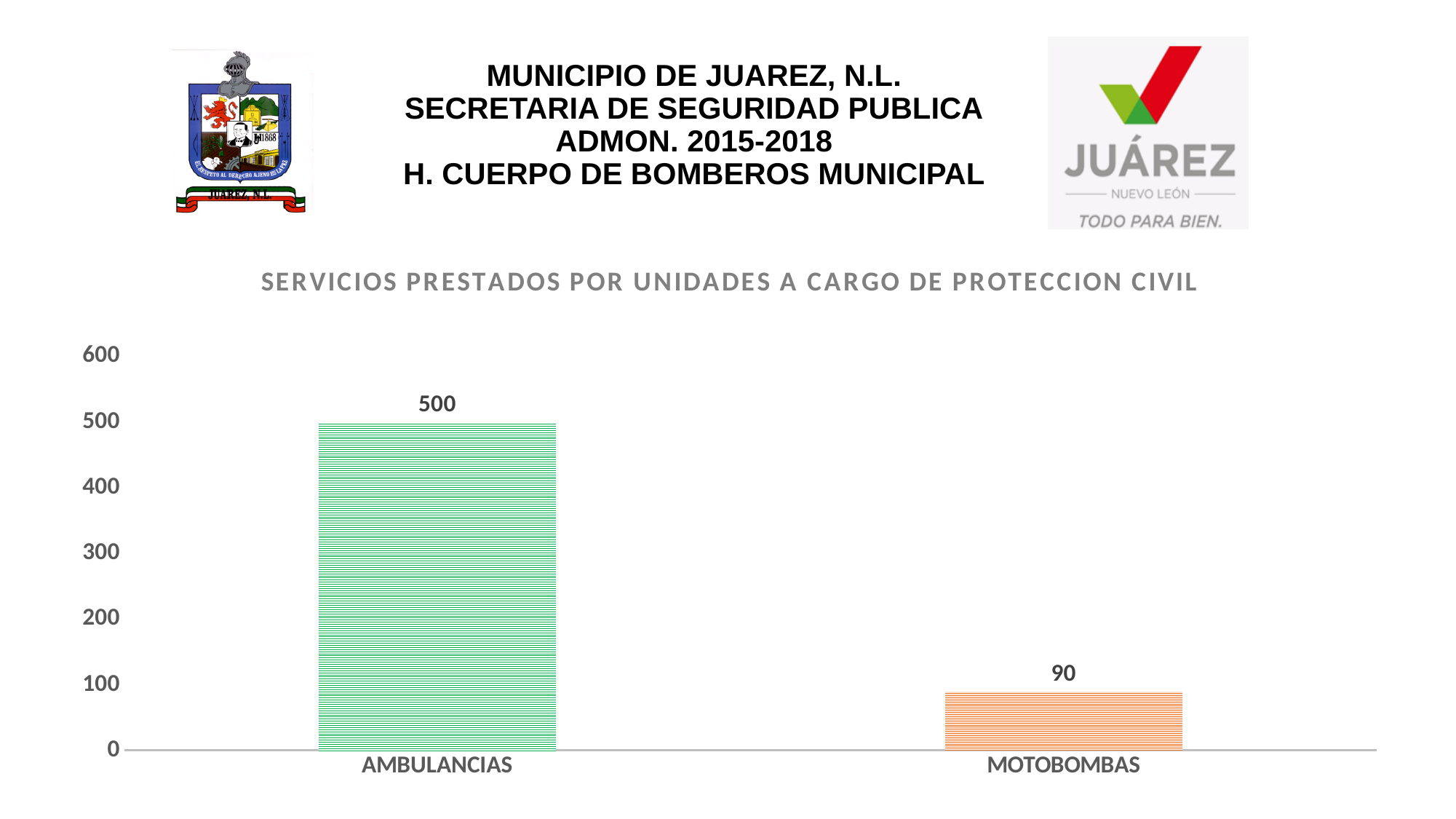
Which is larger, the value for AMBULANCIAS or the value for MOTOBOMBAS? AMBULANCIAS What is the value for AMBULANCIAS? 500 What colour is the bar for MOTOBOMBAS? orange What kind of chart is shown on the slide? bar chart What is the difference between the values for AMBULANCIAS and MOTOBOMBAS? 410 Which category has the highest value? AMBULANCIAS Is the value for MOTOBOMBAS greater or less than 100? less How many categories are shown on the chart? 2 What is the title of the chart? SERVICIOS PRESTADOS POR UNIDADES A CARGO DE PROTECCION CIVIL What is the value for MOTOBOMBAS? 90 Which category has the lowest value? MOTOBOMBAS Is the value for AMBULANCIAS greater or less than 400? greater